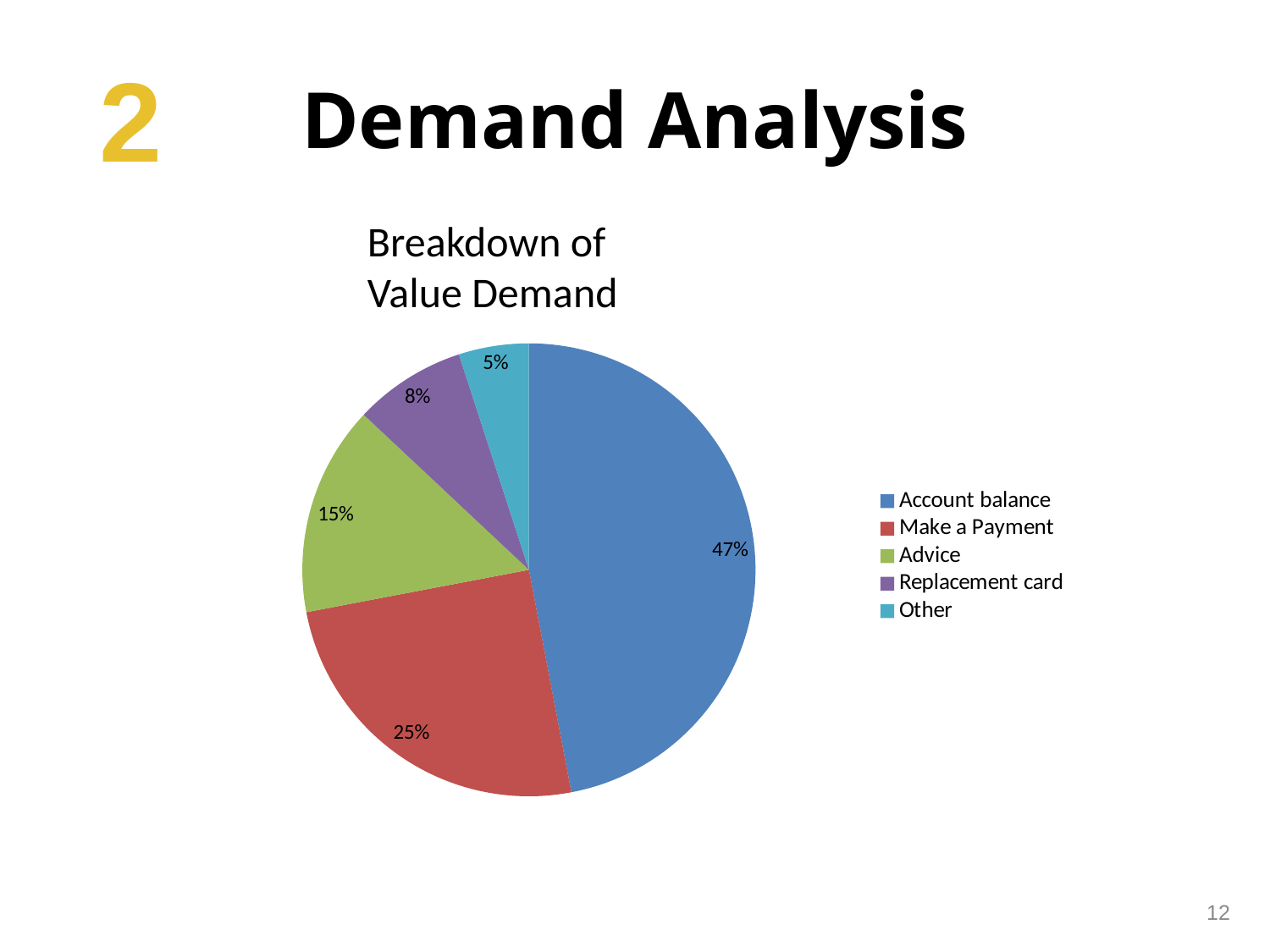
What share of the pie does Replacement card represent? 8% How many categories does the legend list? 5 What is the title of the chart? Breakdown of Value Demand Which category has the largest share of the pie? Account balance What share of the pie does Advice represent? 15% What share of the pie does Other represent? 5% What type of chart is shown on the slide? Pie chart Which category has the smallest share of the pie? Other Which is larger, the share for Advice or the share for Replacement card? Advice What is the difference in percentage points between Account balance and Make a Payment? 22